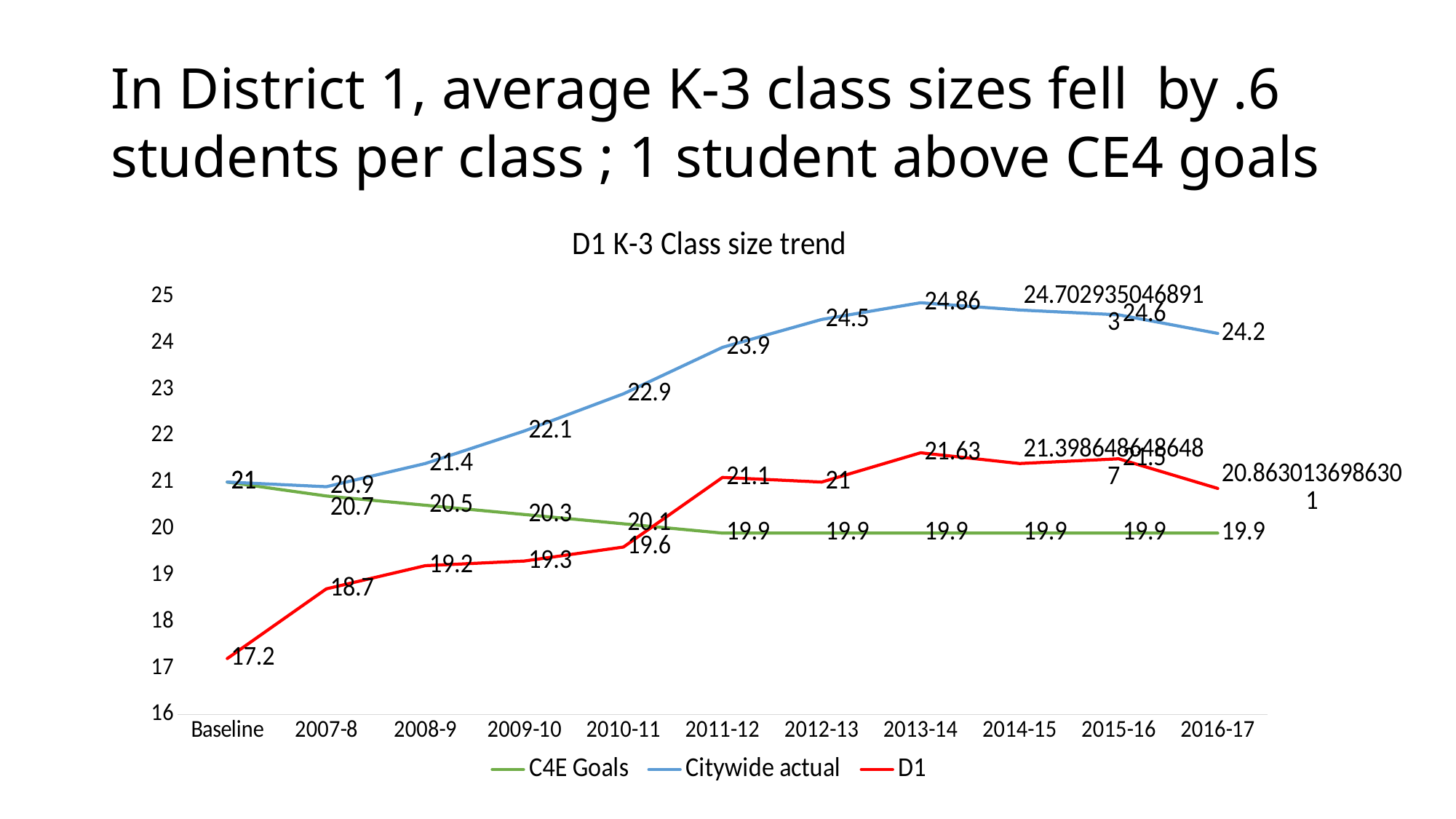
Does the Citywide actual series generally rise or fall from Baseline to 2013-14? rise How many points along the x axis does the chart have? 11 In which year does the Citywide actual series reach its highest value? 2013-14 What kind of chart is shown on the slide? line chart What is the Citywide actual value for 2013-14? 24.86 By how much did the D1 value increase from Baseline to 2007-8? 1.5 How many series does the legend of the 'D1 K-3 Class size trend' chart list? 3 What is the D1 value at Baseline? 17.2 At which point on the x axis is the D1 series lowest? Baseline In 2016-17, which is larger: the Citywide actual value or the C4E Goals value? Citywide actual What is the C4E Goals value for 2009-10? 20.3 What is the difference between the Citywide actual and D1 values in 2012-13? 3.5